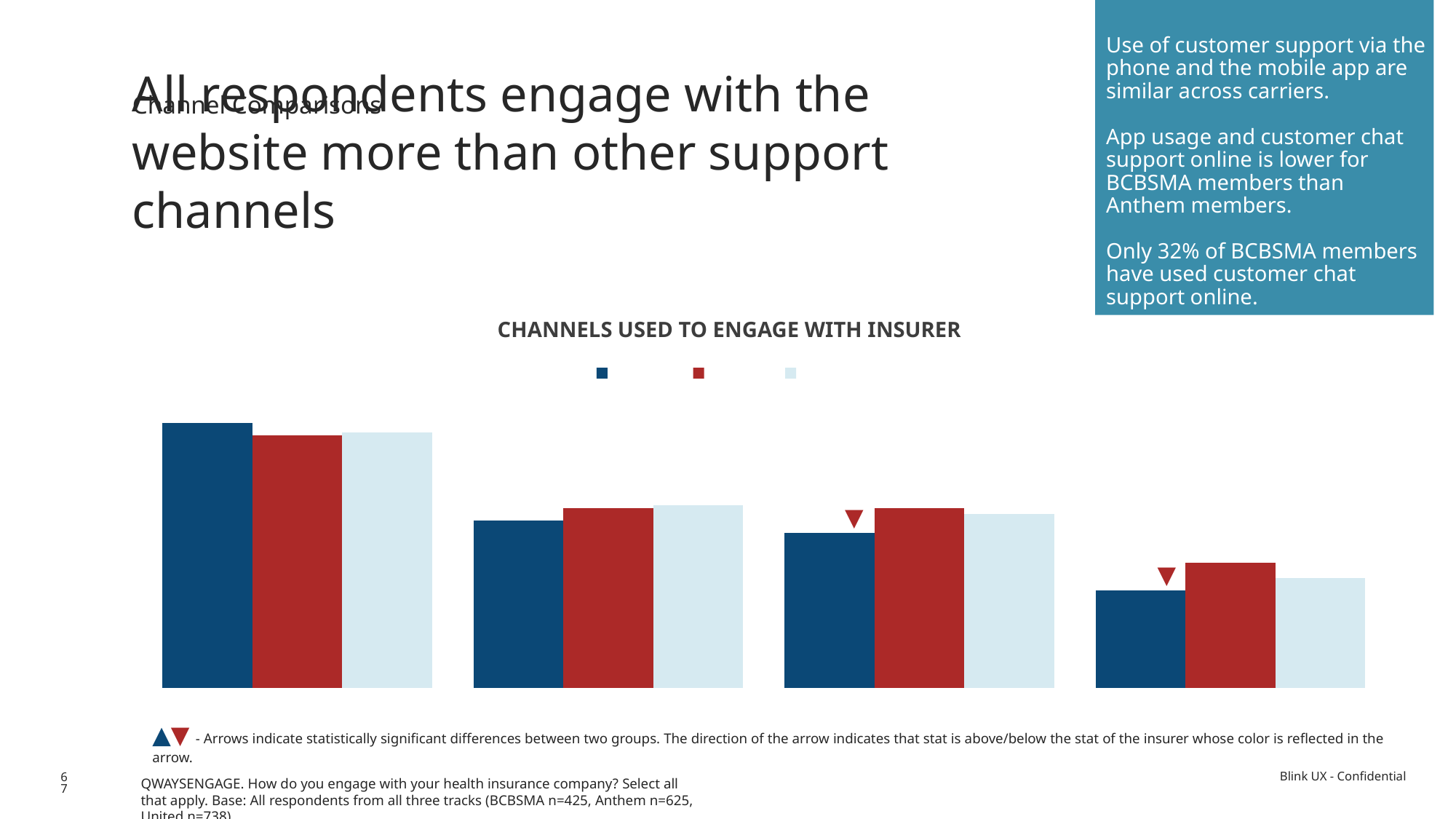
What kind of chart is shown on the slide? bar chart Which group of bars, counting from the left, has the tallest bars in the chart? the first (leftmost) group What colours are the three series in the chart? dark blue, red and light blue Which group of bars, counting from the left, has the shortest bars in the chart? the fourth (rightmost) group How many groups of bars are plotted in the chart? 4 What is the title of the chart? CHANNELS USED TO ENGAGE WITH INSURER Do the dark blue bars rise or fall moving from left to right across the chart? fall In the rightmost group of bars, which series is taller: the dark blue bar or the red bar? the red bar How many series does the chart's legend show? 3 In the leftmost group of bars, which series is taller: the dark blue bar or the red bar? the dark blue bar In the third group of bars from the left, which series is taller: the dark blue bar or the light blue bar? the light blue bar